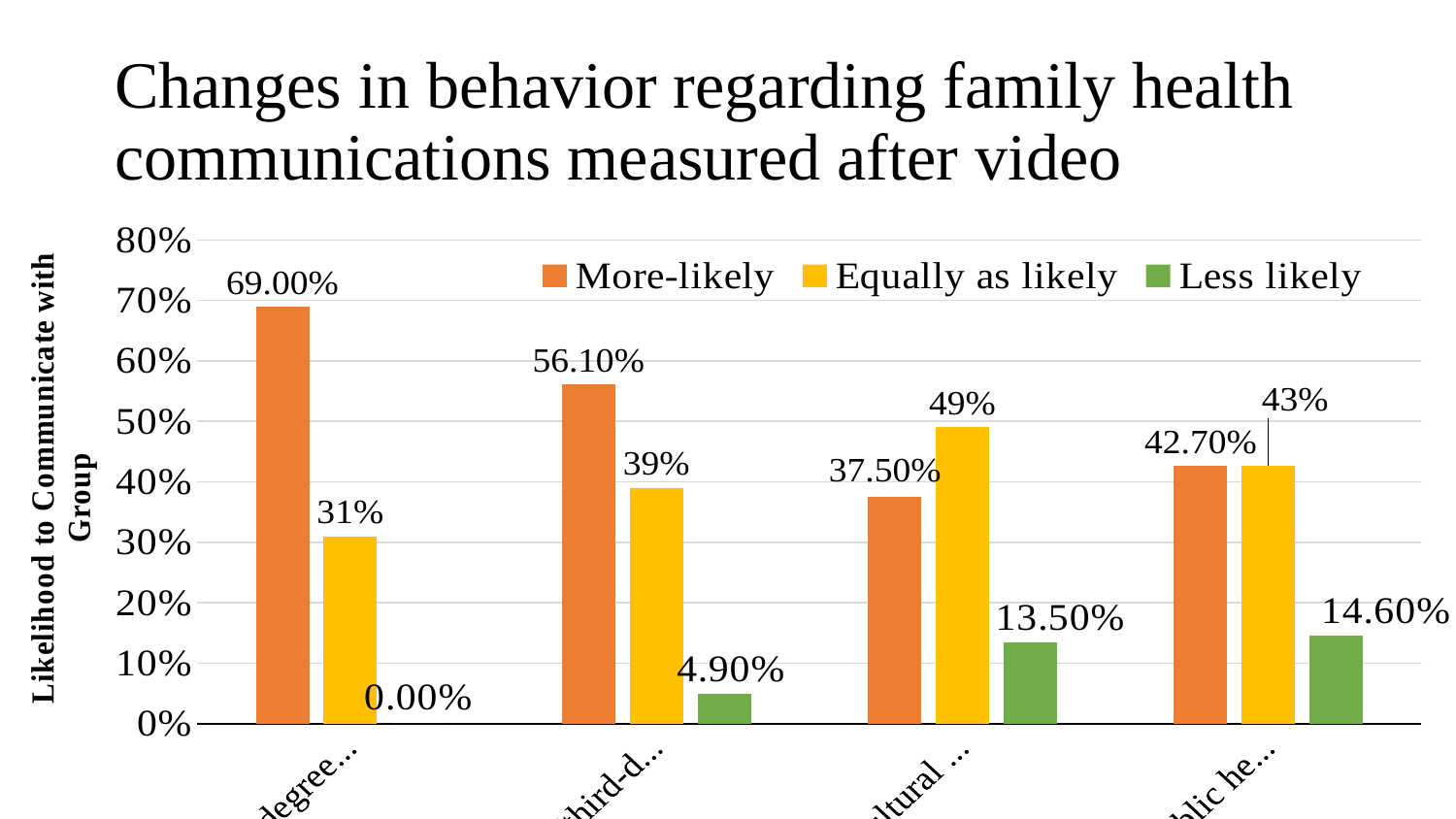
What kind of chart is shown on the slide? bar chart What is the Equally as likely value for the fourth (rightmost) group? 43% How many series does the legend list? 3 What is the More-likely value for the first (leftmost) group? 69.00% What is the highest value shown for the More-likely series? 69.00% In the third group from the left, which is larger: the More-likely value or the Equally as likely value? Equally as likely What is the lowest value shown for the Less likely series? 0.00% How many category groups are plotted along the x axis? 4 In the first (leftmost) group, what is the difference between the More-likely value and the Equally as likely value? 38% Do the Less likely values rise or fall moving from left to right across the groups? rise What is the title of the vertical axis? Likelihood to Communicate with Group What is the Less likely value for the second group from the left? 4.90%